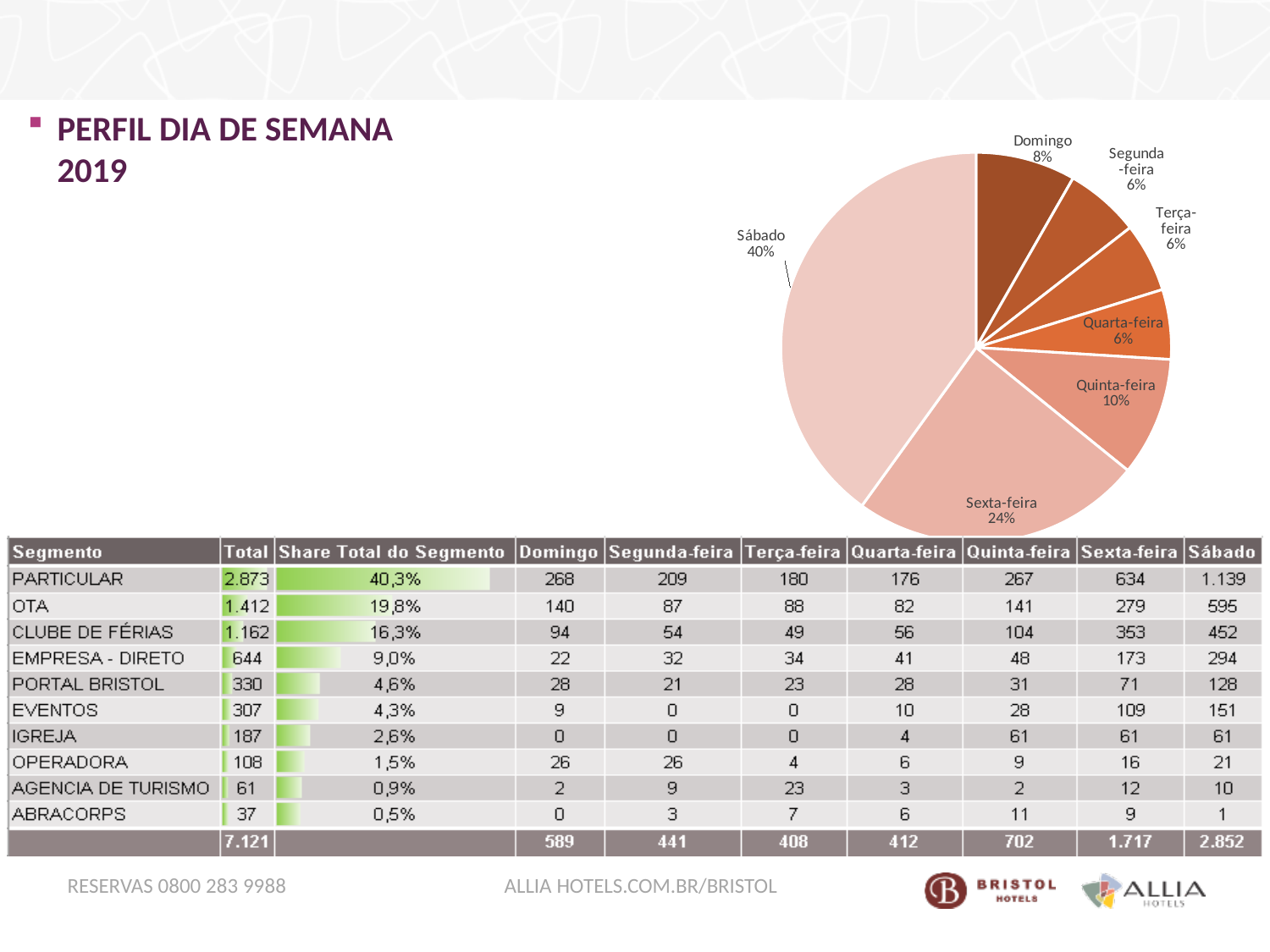
What is the title of the slide containing the pie chart? PERFIL DIA DE SEMANA 2019 What percentage is shown for Domingo in the pie chart? 8% What is the difference in percentage points between Sexta-feira and Quinta-feira in the pie chart? 14 Which day has the largest slice of the pie chart? Sábado What share of the pie does Sábado represent? 40% Which has a larger share in the pie chart, Sexta-feira or Domingo? Sexta-feira How many slices does the pie chart have? 7 What is the difference in percentage points between Sábado and Sexta-feira in the pie chart? 16 What kind of chart is shown on the slide? pie chart What percentage is shown for Quinta-feira in the pie chart? 10% What percentage is shown for Sexta-feira in the pie chart? 24% Which has a larger share in the pie chart, Quinta-feira or Domingo? Quinta-feira